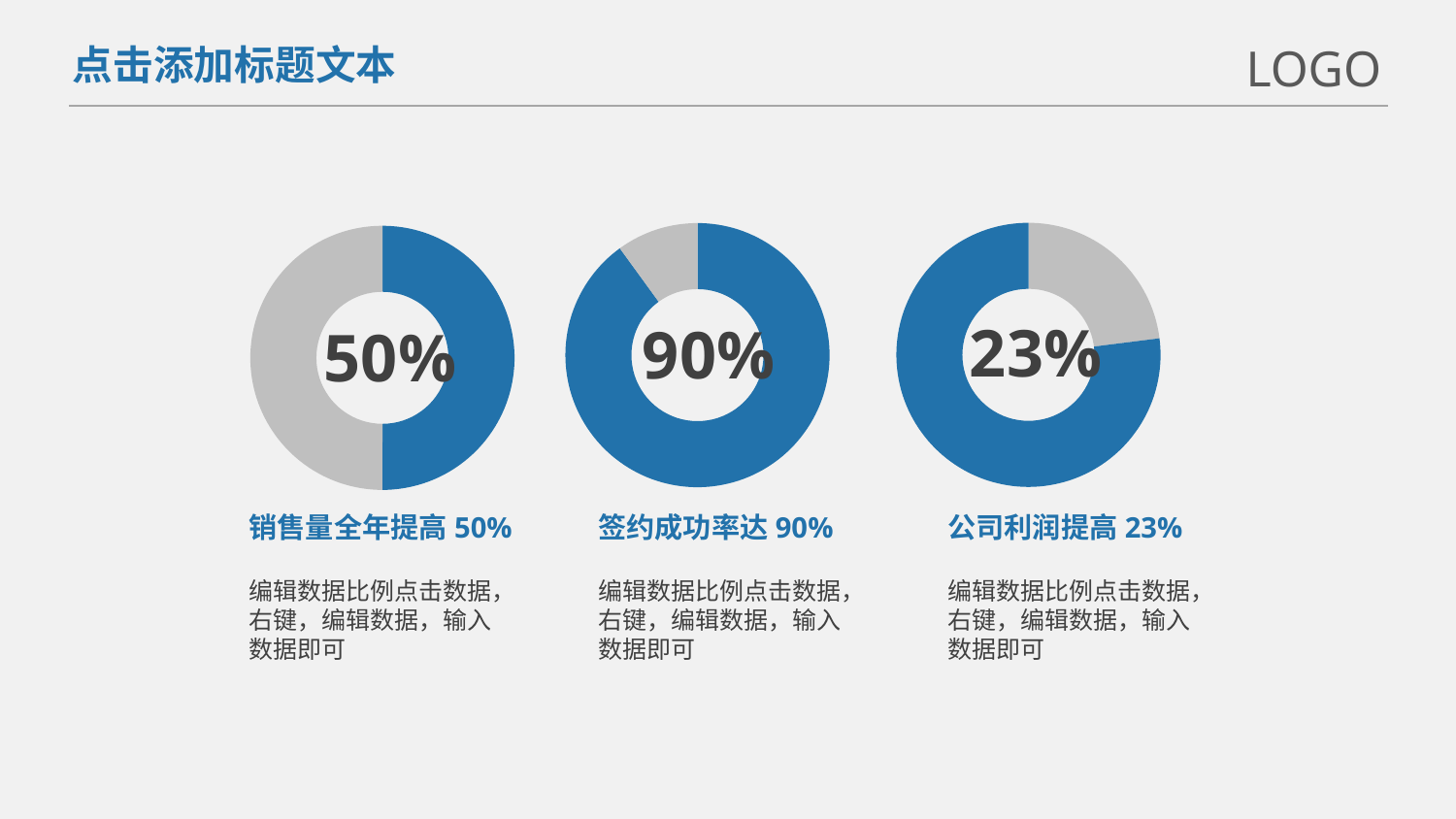
What is the difference between the percentage in the left chart and the percentage in the right chart? 27% Which of the three donut charts shows the lowest percentage? The right chart (23%) What is the difference between the percentage in the middle chart and the percentage in the left chart? 40% Which of the three donut charts shows the highest percentage? The middle chart (90%) Is the percentage in the left donut chart larger or smaller than the percentage in the right donut chart? Larger What is the caption under the right donut chart? 公司利润提高 23% What percentage is shown in the centre of the middle donut chart? 90% How many donut charts are on the slide? 3 What is the caption under the middle donut chart? 签约成功率达 90% What percentage is shown in the centre of the right donut chart? 23% What kind of charts are shown on the slide? Donut charts What percentage is shown in the centre of the left donut chart? 50%